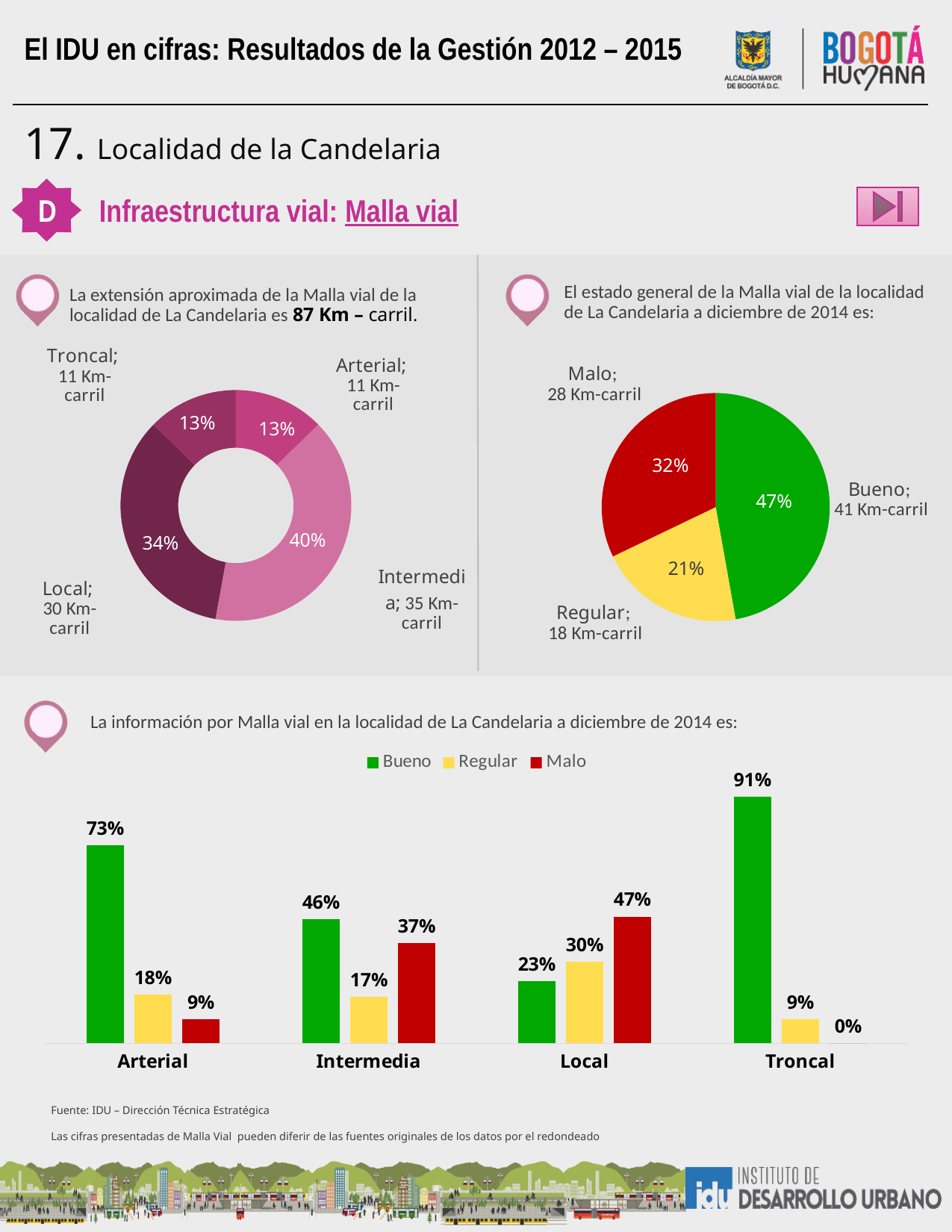
How many categories are shown on the x axis of the bottom bar chart? 4 What kind of chart is the one at the bottom of the slide? Bar chart In the bottom bar chart, what is the value of Bueno for Troncal? 91% How many series does the legend of the bottom bar chart list? 3 In the donut chart on the left, which category has the largest share? Intermedia In the bottom bar chart, what is the difference between the Bueno and Regular values for Arterial? 55% In the bottom bar chart, what is the value of Malo for Local? 47% In the bottom bar chart, which is larger for Intermedia: Bueno or Malo? Bueno In the bottom bar chart, which category has the highest Bueno value? Troncal In the bottom bar chart, which category has the lowest Malo value? Troncal In the pie chart on the right, what share does Malo have? 32% In the pie chart on the right, how many Km-carril are in Bueno state? 41 Km-carril